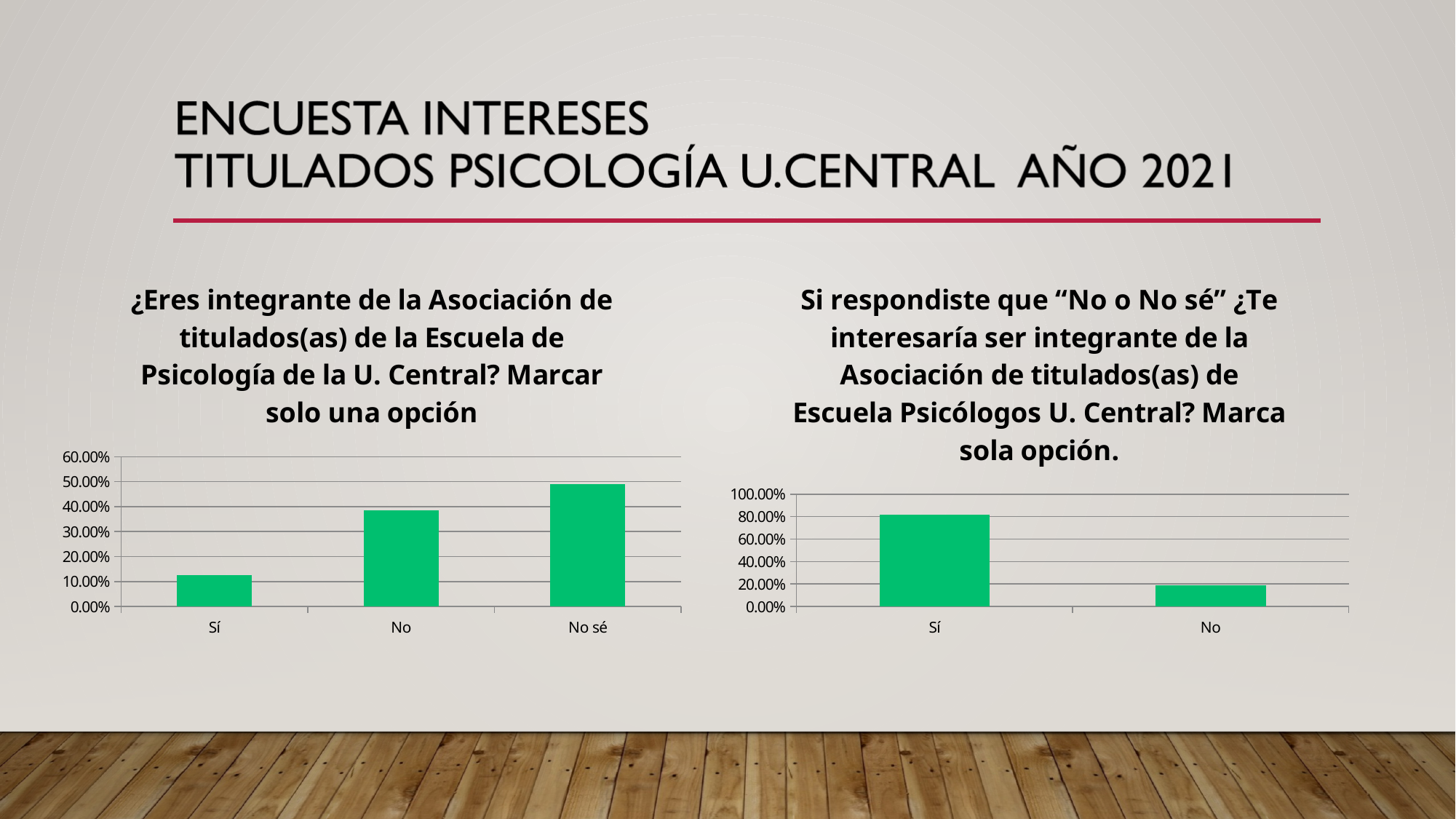
In the right chart (Si respondiste que “No o No sé” ¿Te interesaría ser integrante...?), which category has the highest value? Sí In the right chart (Si respondiste que “No o No sé” ¿Te interesaría ser integrante...?), is the value for Sí greater or less than 60.00%? greater In the left chart (¿Eres integrante de la Asociación de titulados(as)...?), is the value for Sí greater or less than 20.00%? less What is the highest value shown on the y axis of the right chart (Si respondiste que “No o No sé” ¿Te interesaría ser integrante...?)? 100.00% In the left chart (¿Eres integrante de la Asociación de titulados(as)...?), is the value for No sé greater or less than 40.00%? greater In the left chart (¿Eres integrante de la Asociación de titulados(as)...?), which category has the highest value? No sé In the left chart (¿Eres integrante de la Asociación de titulados(as)...?), which is larger, the value for No or the value for Sí? No How many categories are shown in the left chart (¿Eres integrante de la Asociación de titulados(as)...?)? 3 How many categories are shown in the right chart (Si respondiste que “No o No sé” ¿Te interesaría ser integrante...?)? 2 In the left chart (¿Eres integrante de la Asociación de titulados(as)...?), which category has the lowest value? Sí What kind of chart is the left chart (¿Eres integrante de la Asociación de titulados(as)...?)? bar chart